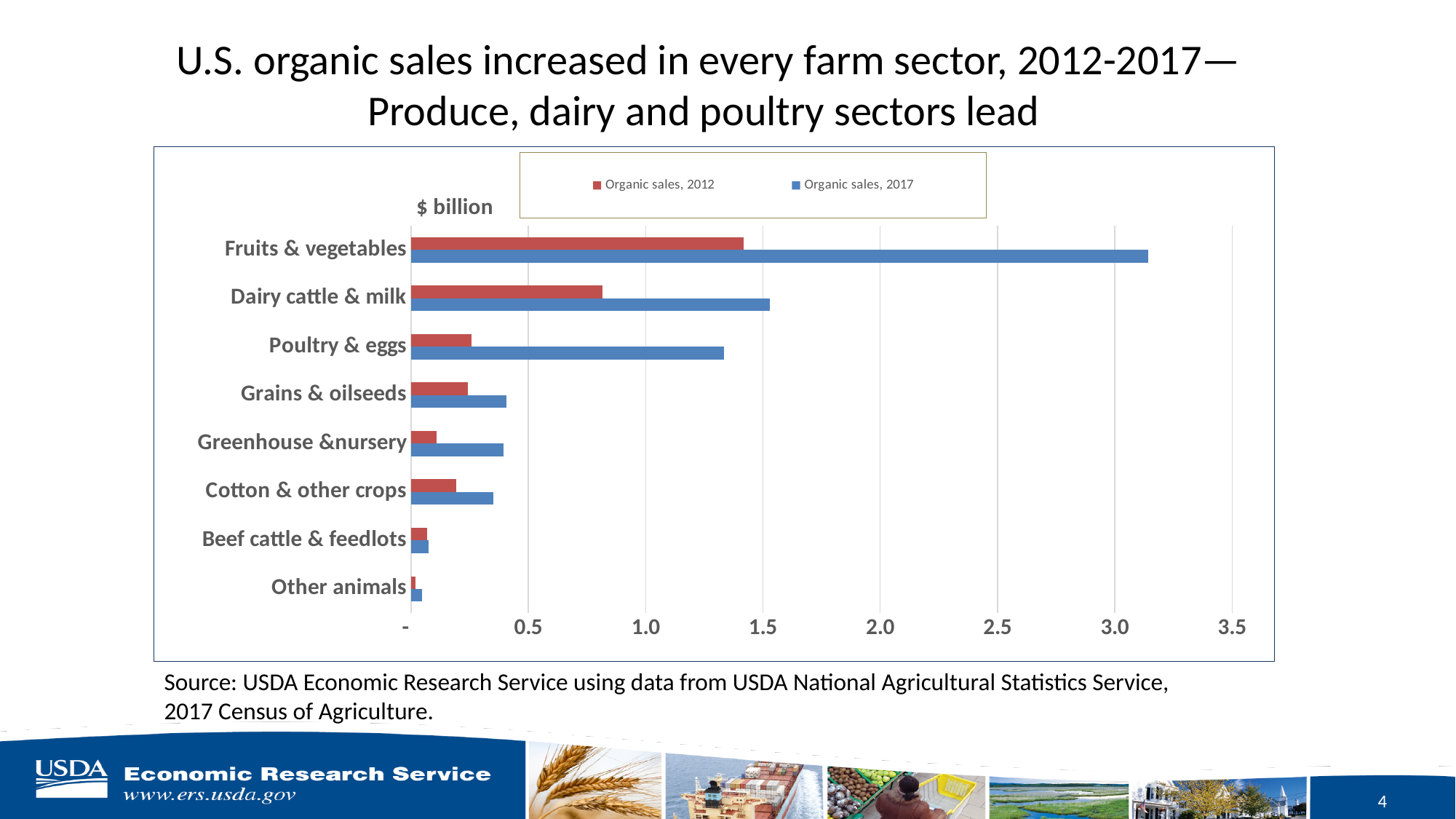
Is the value for Fruits & vegetables organic sales in 2012 greater or less than 1.5? less How many farm sector categories are plotted on the chart? 8 What kind of chart is shown on the slide? bar chart What unit is shown for the values on the chart's axis? $ billion Which colour represents Organic sales, 2017 in the legend? blue Which is larger: organic sales in 2017 for Dairy cattle & milk or for Poultry & eggs? Dairy cattle & milk Is the value for Dairy cattle & milk organic sales in 2012 greater or less than 1.0? less Which farm sector has the lowest organic sales in 2017? Other animals Is the value for Poultry & eggs organic sales in 2017 greater or less than 1.0? greater How many series does the legend list? 2 Which farm sector has the highest organic sales in 2017? Fruits & vegetables